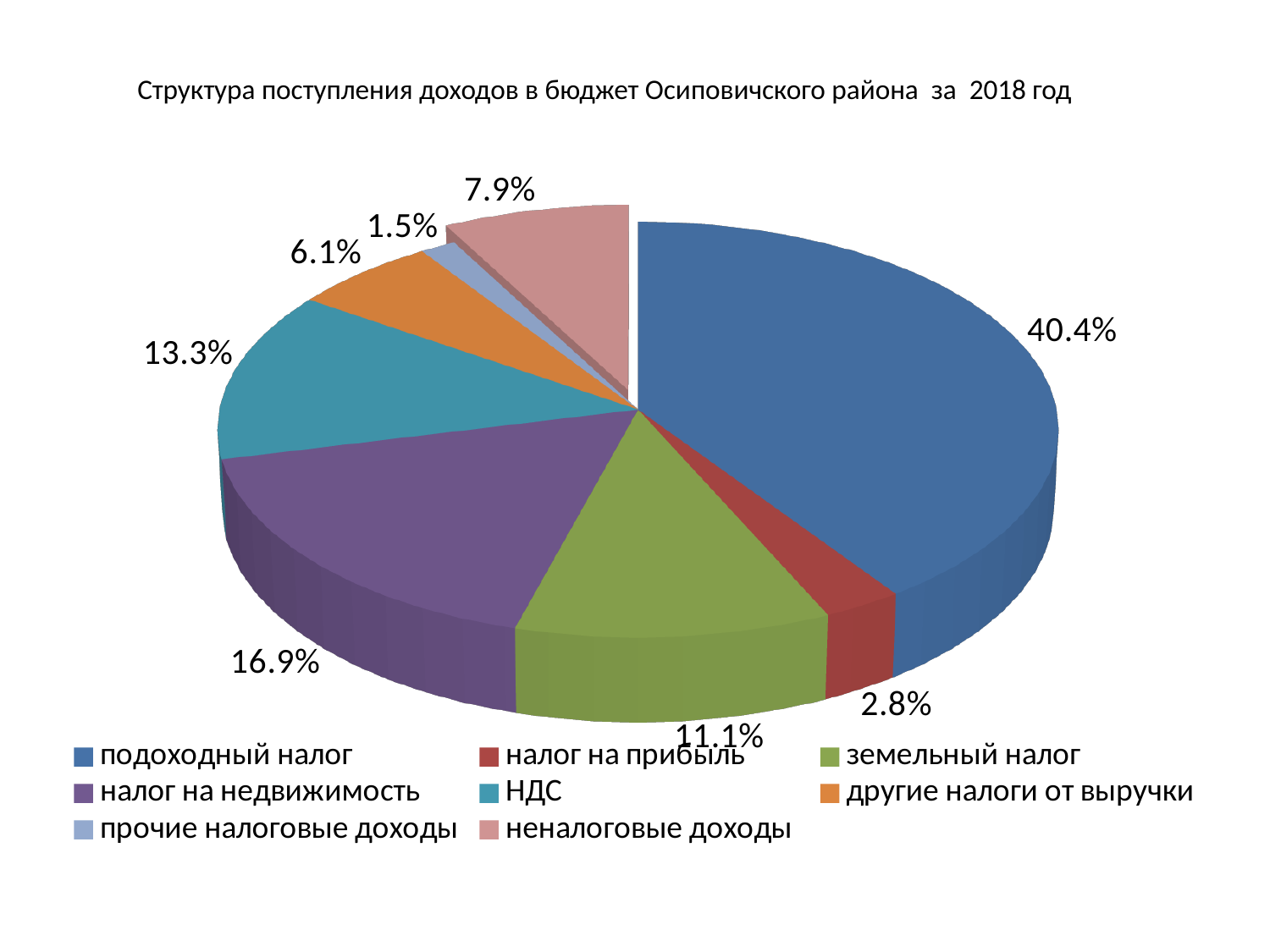
Which category has the largest share of the pie? подоходный налог What share of the pie is НДС? 13.3% What colour is the slice for налог на прибыль? Red Which category has the smallest share of the pie? прочие налоговые доходы What share of the pie is налог на недвижимость? 16.9% What is the title of the chart? Структура поступления доходов в бюджет Осиповичского района за 2018 год What share of the pie is неналоговые доходы? 7.9% Which is larger, the share for земельный налог or the share for НДС? НДС What share of the pie is подоходный налог? 40.4% What kind of chart is shown on the slide? Pie chart What is the difference in percentage points between подоходный налог and налог на недвижимость? 23.5 How many categories does the legend list? 8